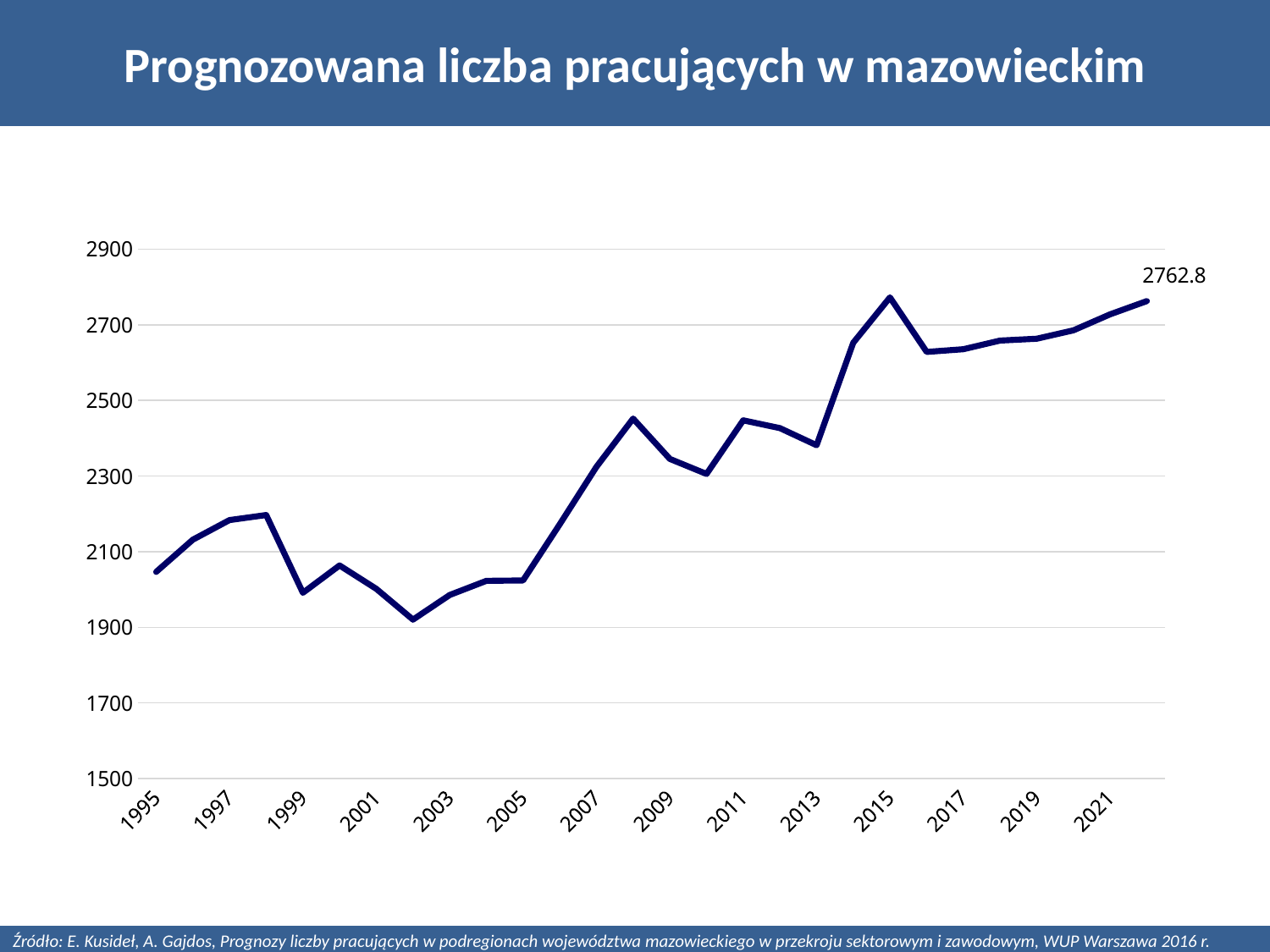
Which is larger, the value for 2015 or the value for 2002? 2015 Is the value for 1995 greater or less than 2000? greater Which year has the lowest value on the chart? 2002 What is the title of the chart? Prognozowana liczba pracujących w mazowieckim What kind of chart is shown on the slide? line chart Overall, do the values rise or fall from 1995 to the end of the series? rise What is the highest value shown on the y axis? 2900 Is the value for 2008 greater or less than 2500? less Is the value for 2002 greater or less than 2000? less What value is printed as the data label at the end of the line? 2762.8 Which is larger, the value for 2008 or the value for 2010? 2008